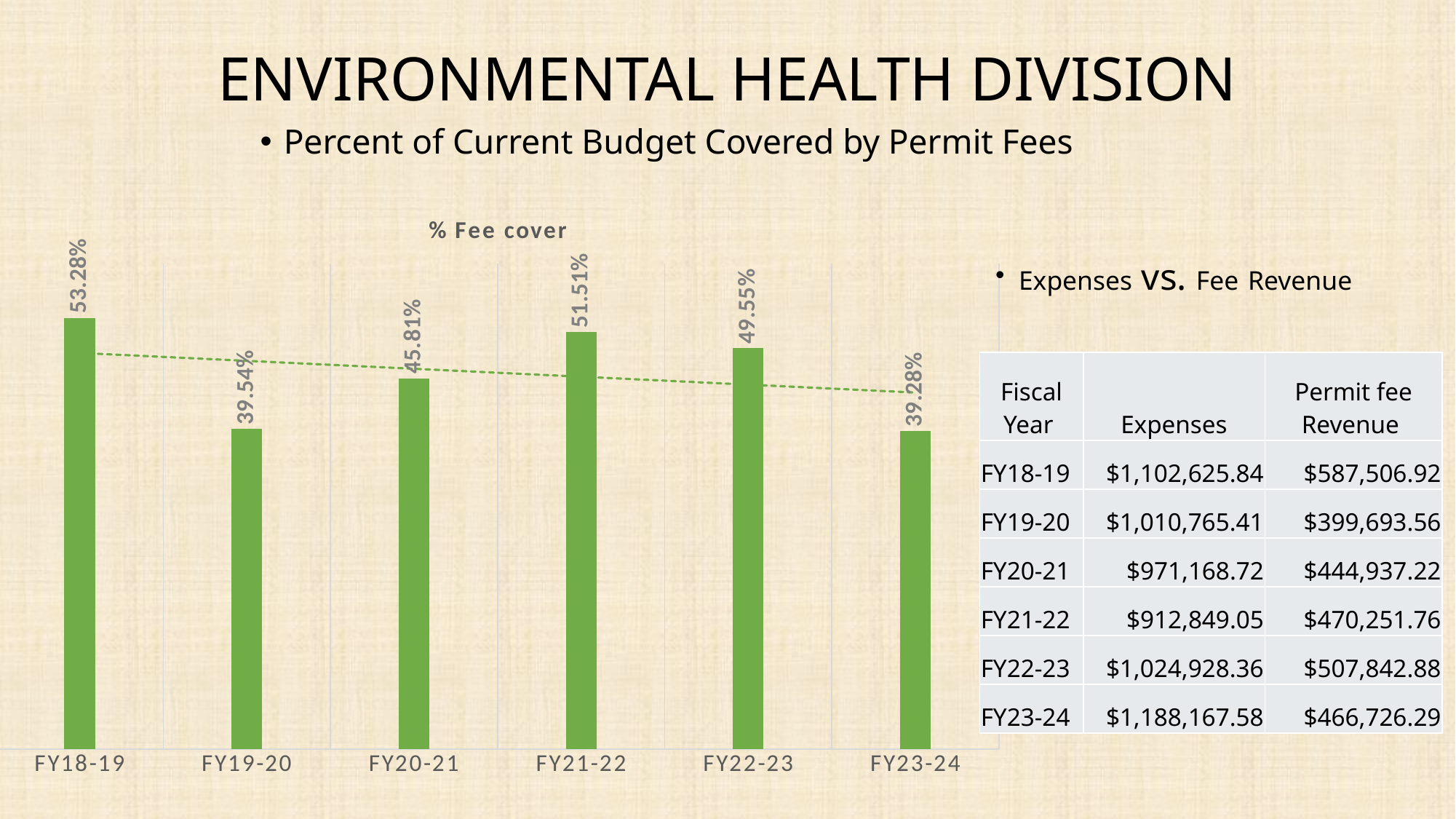
What kind of chart is the % Fee cover chart? Bar chart How many fiscal years are shown in the % Fee cover chart? 6 What is the difference between the FY21-22 and FY22-23 values in the % Fee cover chart? 1.96% What colour are the bars in the % Fee cover chart? Green Which fiscal year has the lowest value in the % Fee cover chart? FY23-24 What is the value for FY23-24 in the % Fee cover chart? 39.28% Which fiscal year has the highest value in the % Fee cover chart? FY18-19 In the % Fee cover chart, which is larger, the value for FY20-21 or the value for FY22-23? FY22-23 What is the difference between the FY18-19 and FY19-20 values in the % Fee cover chart? 13.74% What is the value for FY18-19 in the % Fee cover chart? 53.28% According to the dashed trend line, do the values in the % Fee cover chart generally rise or fall from FY18-19 to FY23-24? Fall What is the value for FY21-22 in the % Fee cover chart? 51.51%